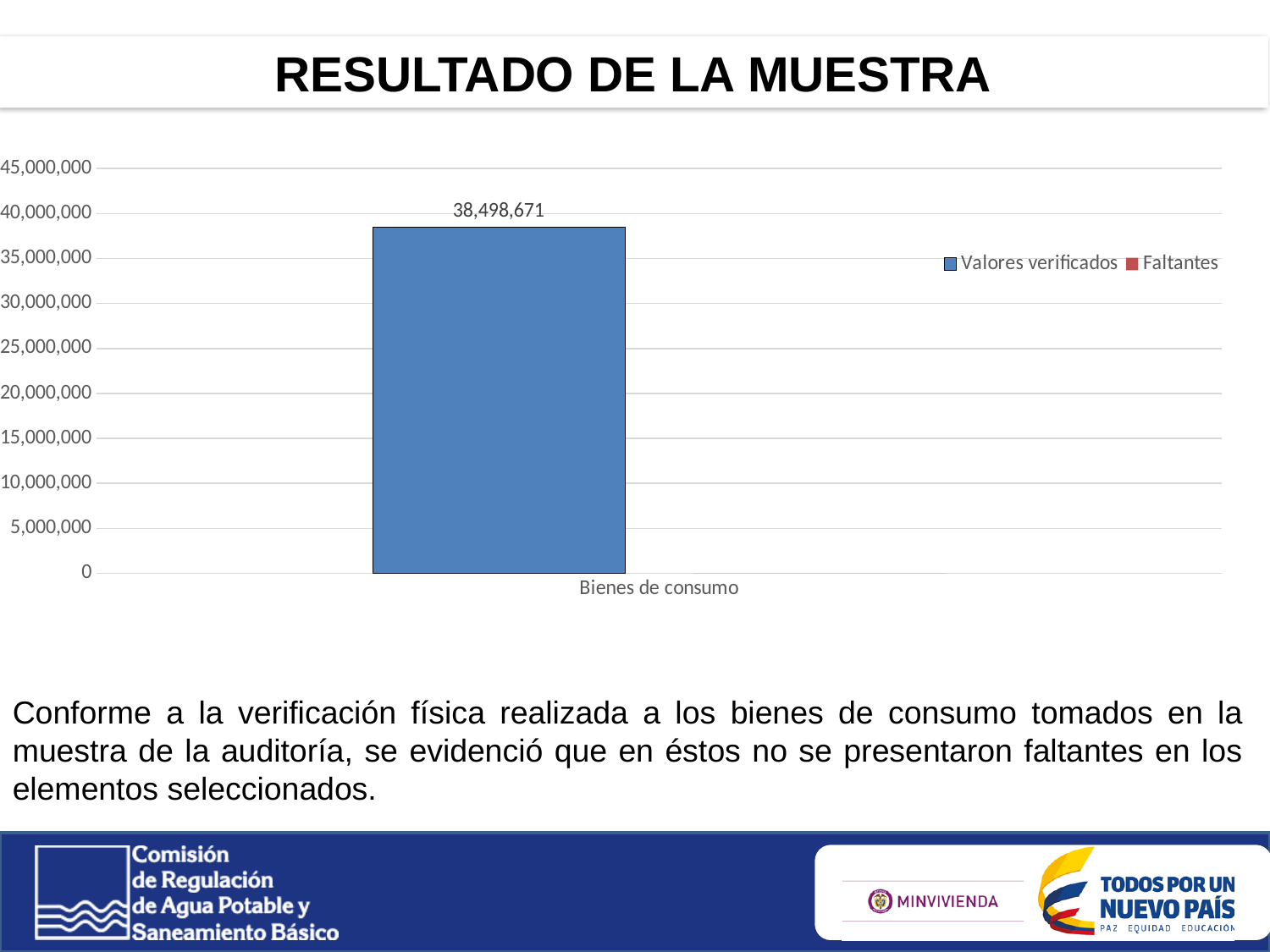
What is the name of the only category on the x axis? Bienes de consumo What is the value of Valores verificados for Bienes de consumo? 38,498,671 Which series has the larger value for Bienes de consumo, Valores verificados or Faltantes? Valores verificados What are the two series named in the legend? Valores verificados and Faltantes Is the value for Valores verificados greater or less than 35,000,000? greater What kind of chart is shown on the slide? Bar chart What colour is the bar for Valores verificados? Blue How many categories are shown on the x axis? 1 How many series does the legend list? 2 Is the value for Valores verificados greater or less than 40,000,000? less